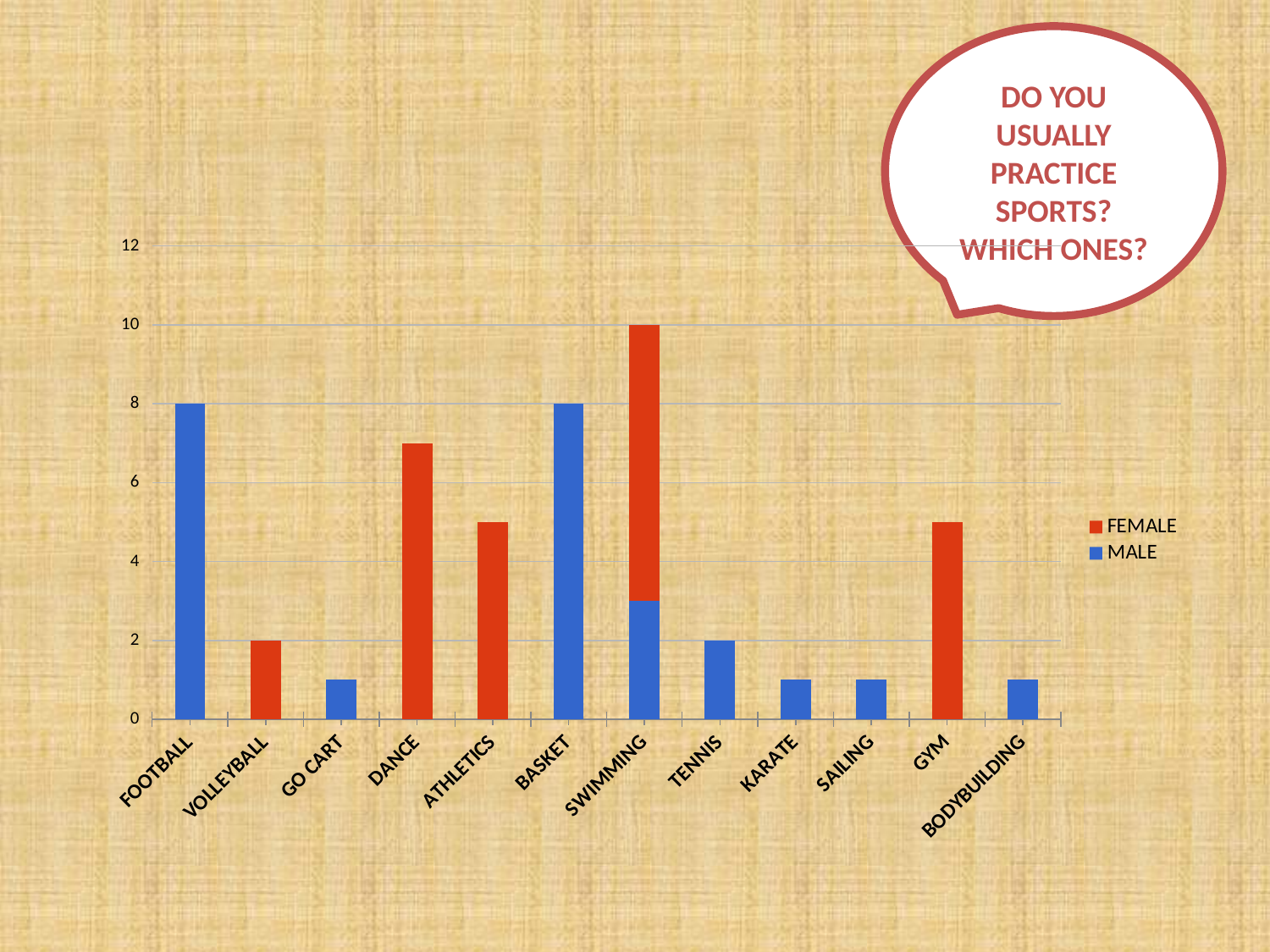
Which series is shown in red in the legend? FEMALE What is the MALE value for FOOTBALL? 8 What is the MALE value for TENNIS? 2 What kind of chart is shown on the slide? bar chart Is the FEMALE value for GYM greater or less than 4? greater How many series does the legend list? 2 Which sport has the tallest stacked bar overall? SWIMMING How many sports categories are shown on the x axis? 12 Is the FEMALE value for DANCE greater or less than 6? greater Which is larger, the FEMALE value for DANCE or the FEMALE value for ATHLETICS? DANCE What is the FEMALE value for VOLLEYBALL? 2 What is the MALE value for BASKET? 8